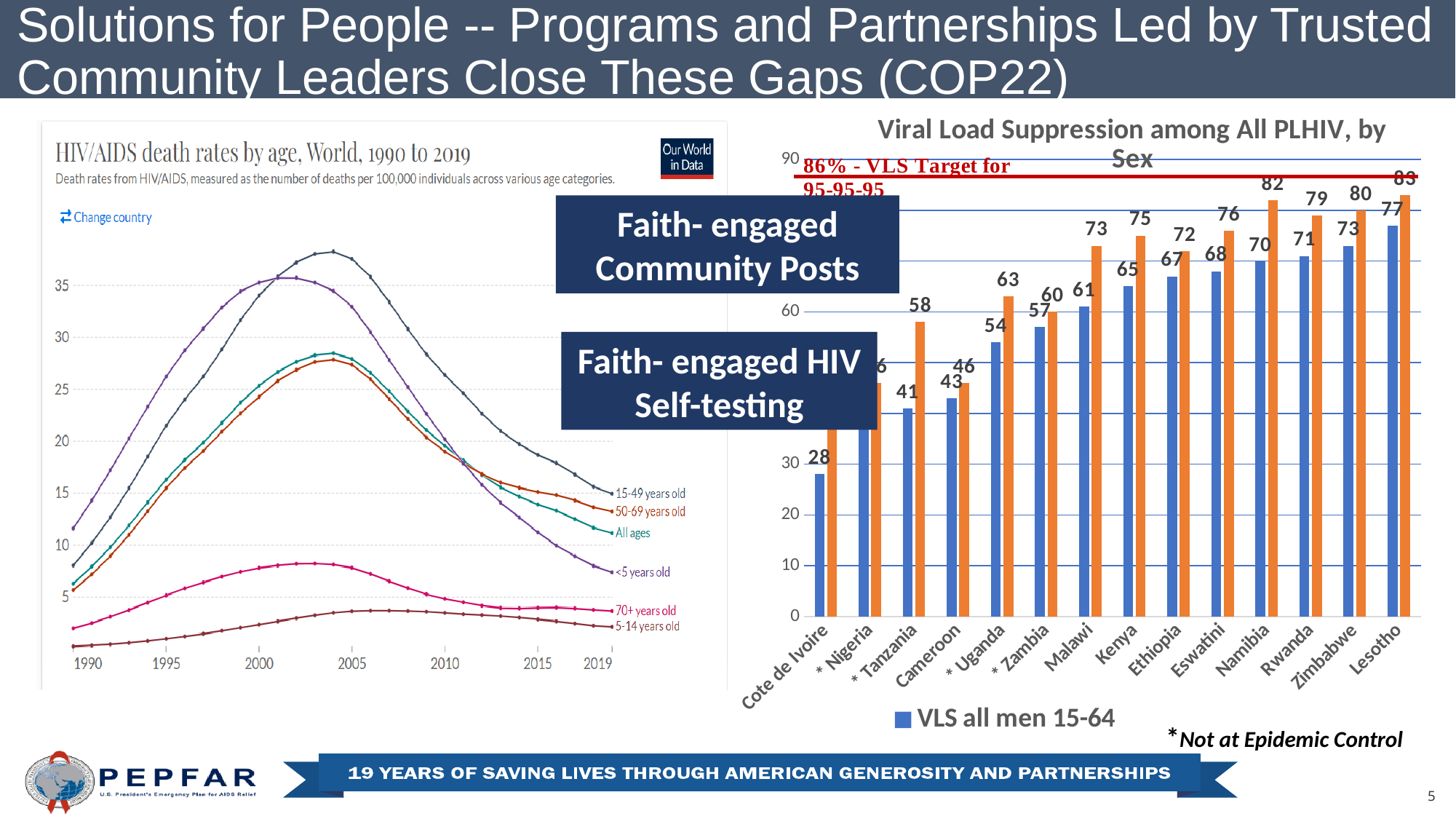
On the 'Viral Load Suppression among All PLHIV, by Sex' chart, what is the VLS all men 15-64 value for Cote de Ivoire? 28 On the 'Viral Load Suppression among All PLHIV, by Sex' chart, how many countries are shown on the x axis? 14 On the 'Viral Load Suppression among All PLHIV, by Sex' chart, which has the higher VLS all men 15-64 value, Kenya or Malawi? Kenya On the 'Viral Load Suppression among All PLHIV, by Sex' chart, what VLS target percentage is marked by the red line? 86% On the 'Viral Load Suppression among All PLHIV, by Sex' chart, which country has the lowest VLS all men 15-64 value? Cote de Ivoire On the 'Viral Load Suppression among All PLHIV, by Sex' chart, what is the VLS all men 15-64 value for Lesotho? 77 On the 'Viral Load Suppression among All PLHIV, by Sex' chart, what is the difference between the VLS all men 15-64 values for Lesotho and Cote de Ivoire? 49 On the 'Viral Load Suppression among All PLHIV, by Sex' chart, which country has the highest VLS all men 15-64 value? Lesotho On the 'HIV/AIDS death rates by age, World, 1990 to 2019' chart, how many age-group series are plotted? 6 What kind of chart is the 'Viral Load Suppression among All PLHIV, by Sex' chart? Bar chart What kind of chart is the 'HIV/AIDS death rates by age, World, 1990 to 2019' chart? Line chart On the 'HIV/AIDS death rates by age, World, 1990 to 2019' chart, is the value for '<5 years old' in 2019 greater or less than 10? less